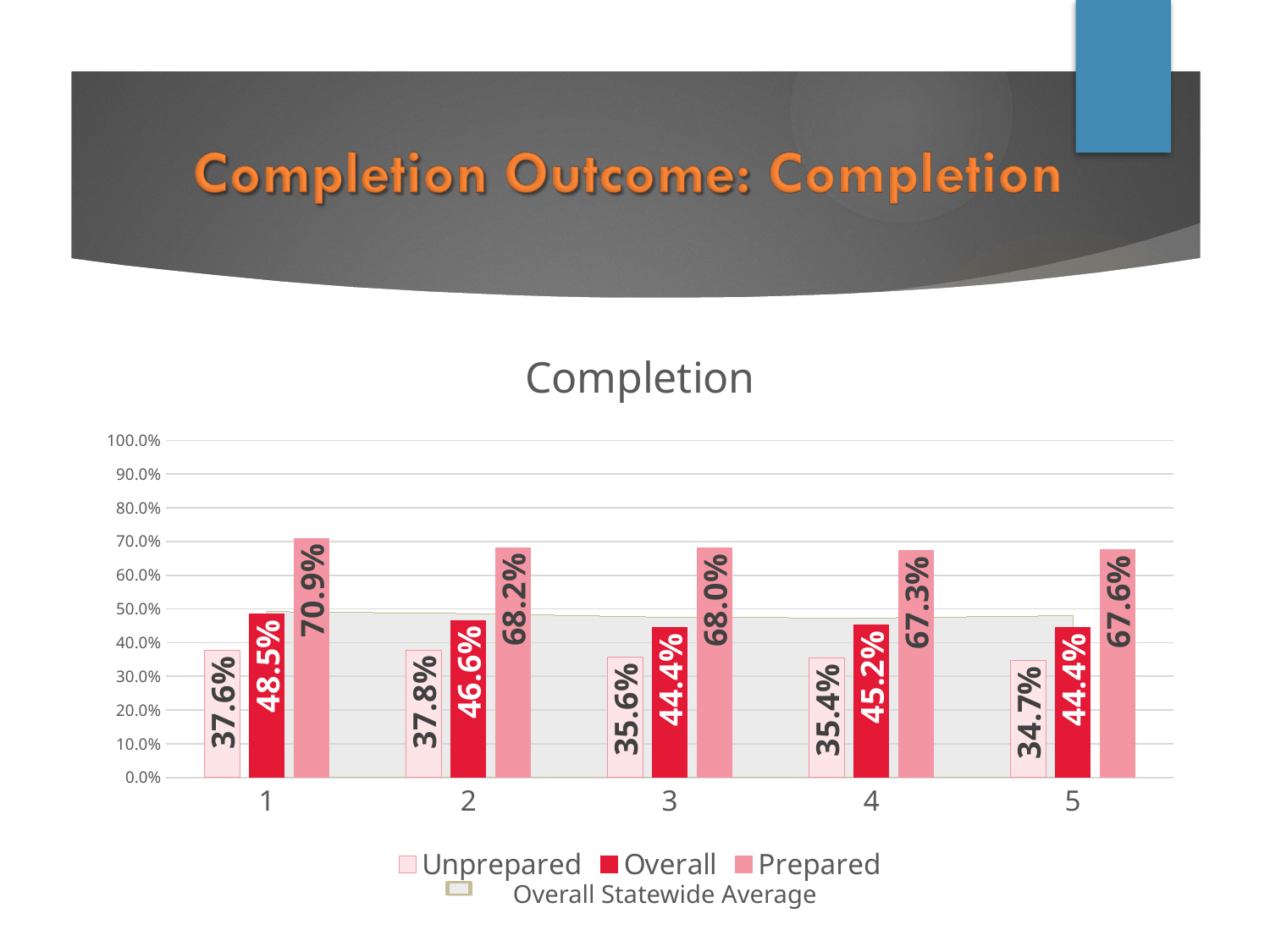
Which category has the lowest Unprepared value? 5 How many categories are shown on the x axis? 5 What is the Unprepared value for category 5? 34.7% Is the Overall Statewide Average for category 1 greater or less than 40.0%? greater Do the Prepared values generally rise or fall from category 1 to category 5? fall What is the Prepared value for category 1? 70.9% How many series does the legend list? 4 What is the Overall value for category 3? 44.4% What is the difference between the Prepared and Unprepared values for category 1? 33.3% Which category has the highest Prepared value? 1 Which is larger for category 2: the Overall value or the Unprepared value? Overall What kind of chart is this? combination bar and area chart